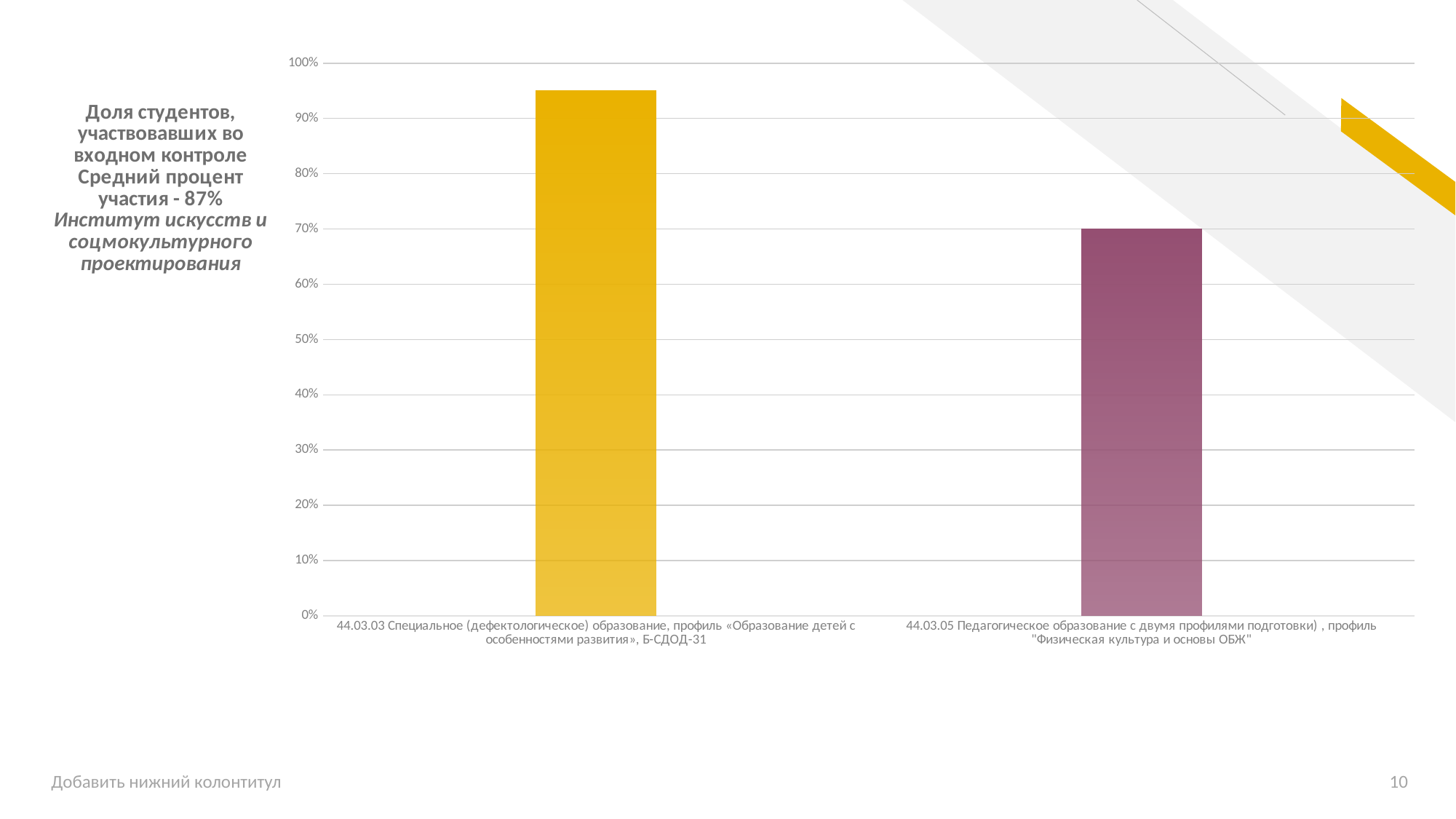
What is the value for 44.03.05 Педагогическое образование с двумя профилями подготовки), профиль "Физическая культура и основы ОБЖ"? 70% Is the value for 44.03.03 Специальное (дефектологическое) образование, Б-СДОД-31 greater or less than 100%? less Do the bar values rise or fall from left to right along the x axis? fall How many categories are plotted in the chart? 2 Which is larger: the value for 44.03.03 Специальное (дефектологическое) образование or the value for 44.03.05 Педагогическое образование? 44.03.03 Специальное (дефектологическое) образование Which category has the lowest bar? 44.03.05 Педагогическое образование с двумя профилями подготовки), профиль "Физическая культура и основы ОБЖ" What average participation percentage is stated in the text next to the chart? 87% What kind of chart is shown on the slide? bar chart Which category has the highest bar? 44.03.03 Специальное (дефектологическое) образование, профиль «Образование детей с особенностями развития», Б-СДОД-31 Is the value for 44.03.03 Специальное (дефектологическое) образование, Б-СДОД-31 greater or less than 90%? greater Is the value for 44.03.05 Педагогическое образование, профиль "Физическая культура и основы ОБЖ" greater or less than 80%? less What is the highest value shown on the vertical axis? 100%